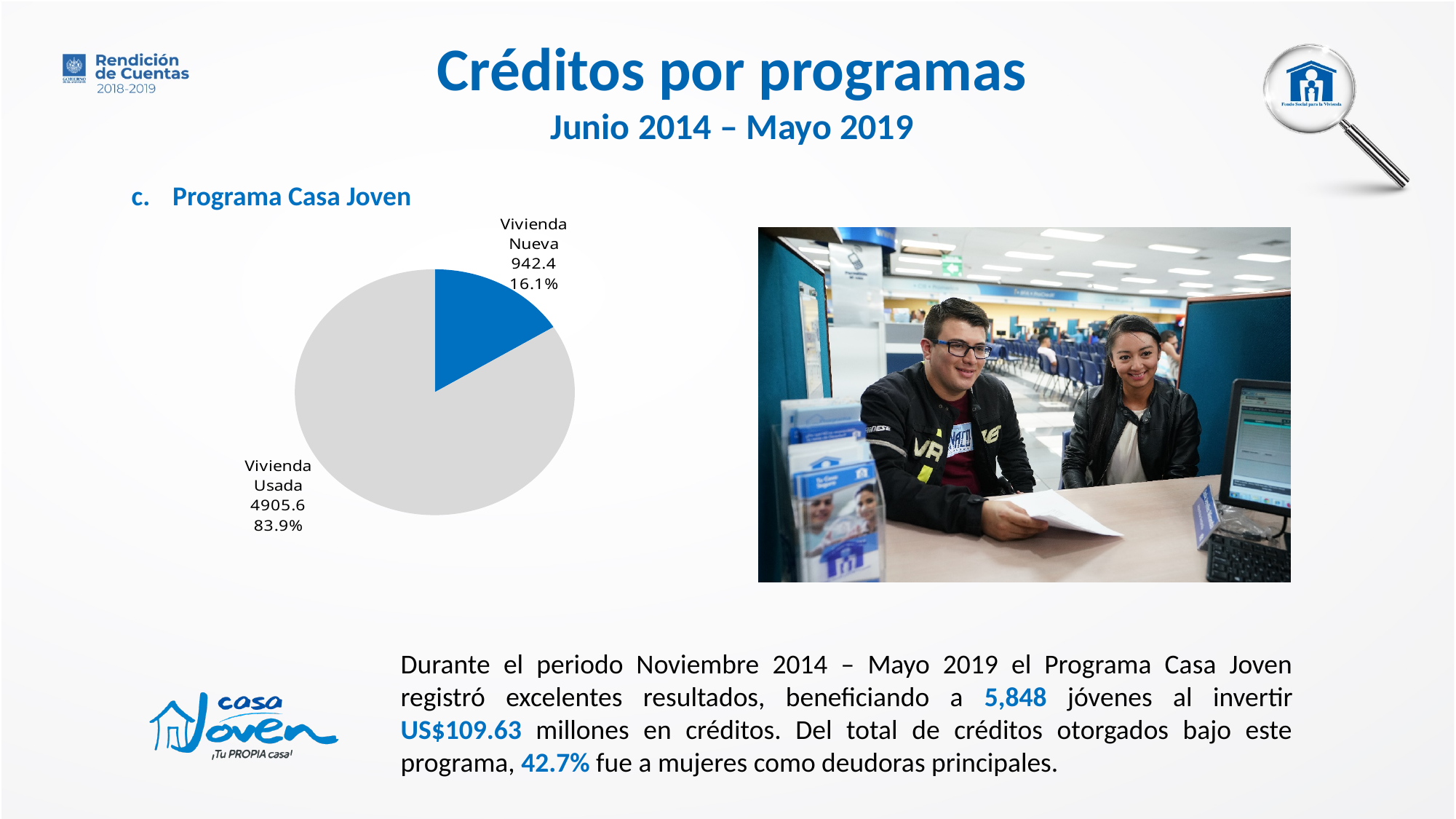
Which category has the smallest slice of the pie? Vivienda Nueva What is the total of the two slices in the pie chart? 5848 What colour is the Vivienda Nueva slice? blue What is the value for Vivienda Nueva? 942.4 How many slices does the pie chart have? 2 What share of the pie does Vivienda Nueva represent? 16.1% What is the value for Vivienda Usada? 4905.6 What kind of chart is shown on the slide? pie chart Which category has the largest slice of the pie? Vivienda Usada Which is larger, Vivienda Nueva or Vivienda Usada? Vivienda Usada What share of the pie does Vivienda Usada represent? 83.9% What is the difference between the values for Vivienda Usada and Vivienda Nueva? 3963.2